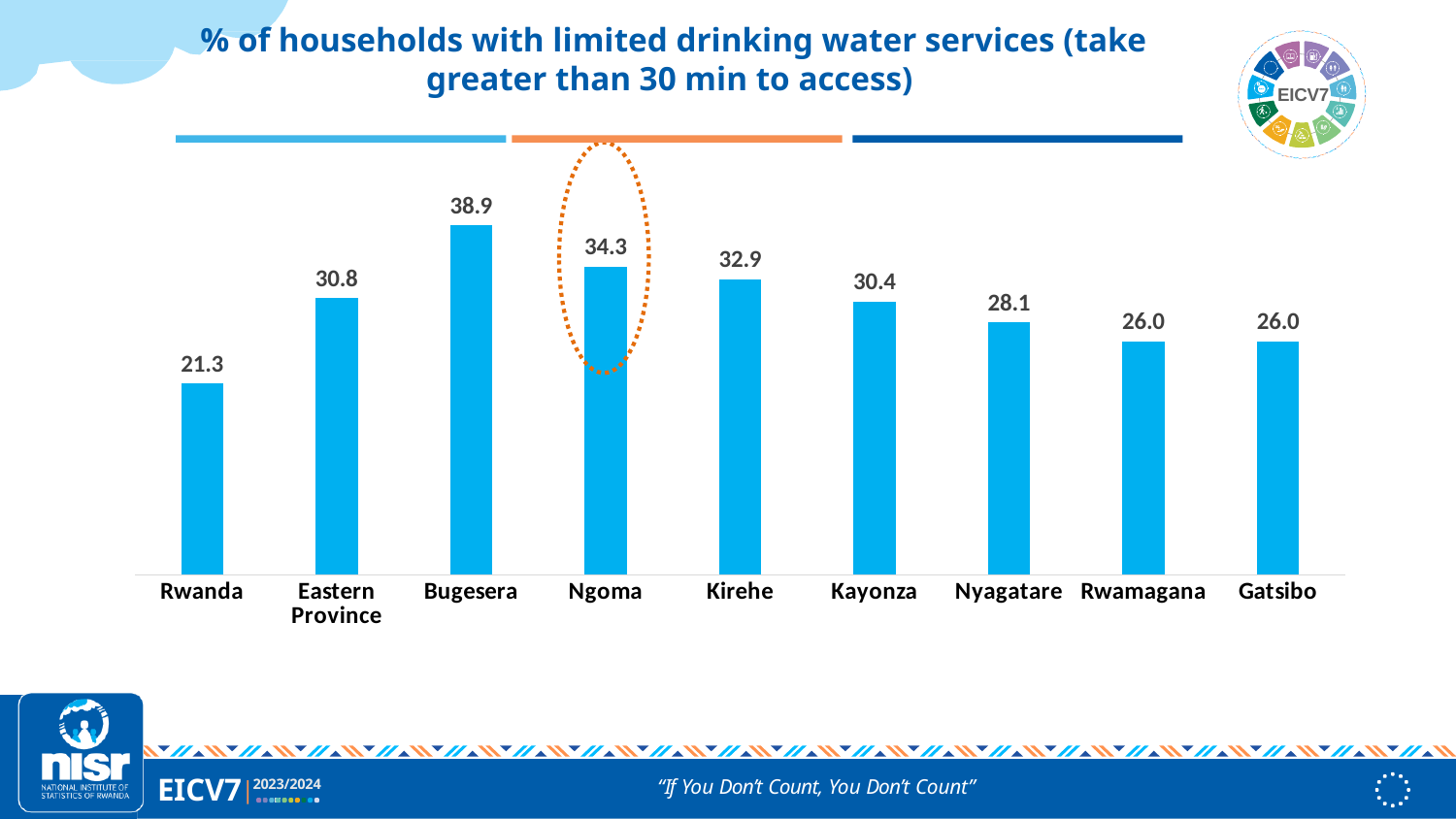
What is the value for Rwanda? 21.3 What is the value for Ngoma? 34.3 How many categories are shown on the x axis? 9 What kind of chart is shown on the slide? bar chart Which two categories share the same value of 26.0? Rwamagana and Gatsibo Which category has the highest value? Bugesera Which category has the lowest value? Rwanda What is the value for Kirehe? 32.9 Which is larger, the value for Kayonza or the value for Nyagatare? Kayonza Which category's bar is highlighted with a dotted orange circle? Ngoma What is the difference between the values for Bugesera and Ngoma? 4.6 What is the difference between the values for Eastern Province and Rwanda? 9.5